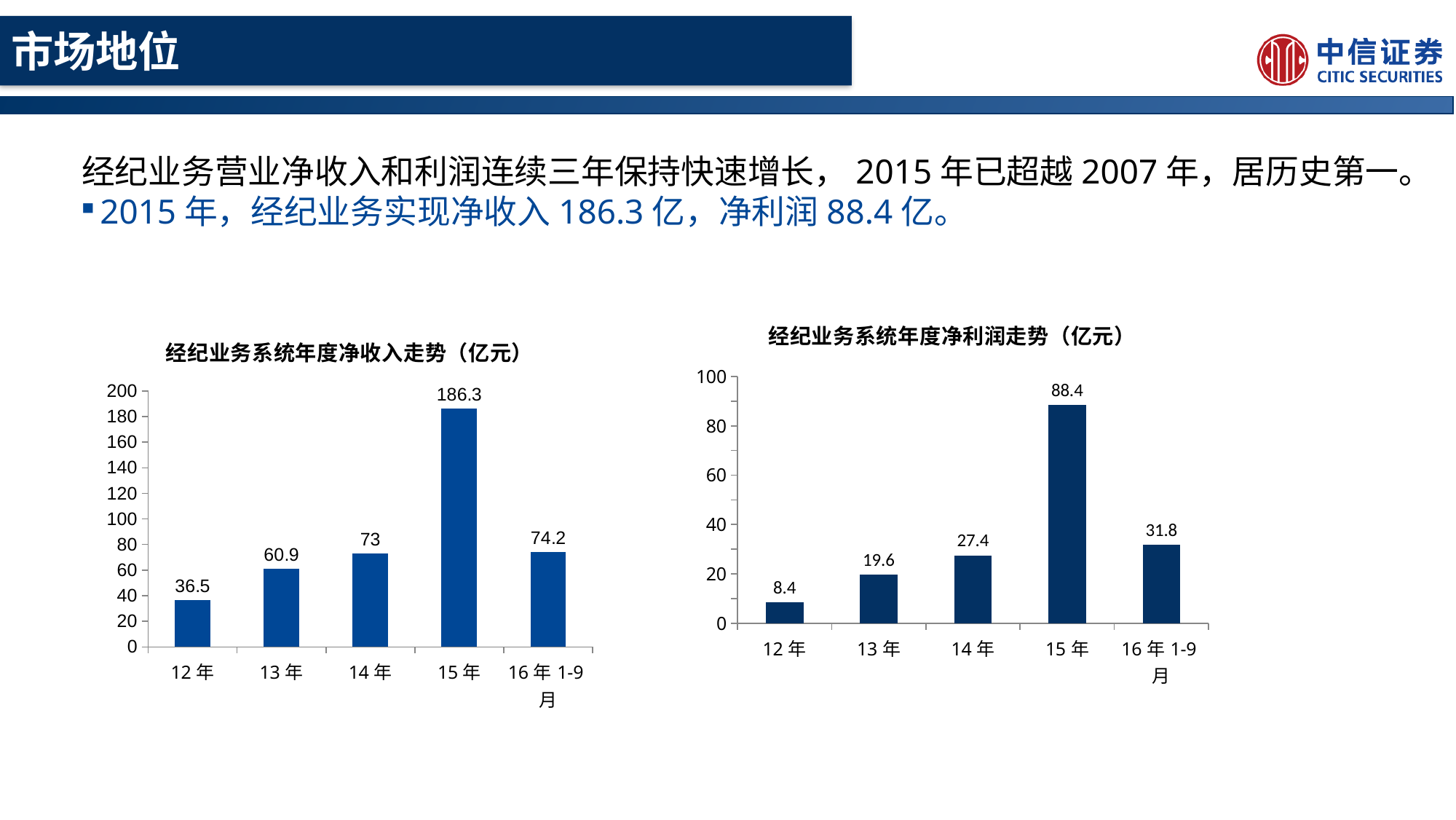
What kind of chart is the right chart (经纪业务系统年度净利润走势)? bar chart In the right chart (经纪业务系统年度净利润走势), do the values rise or fall from 12 年 to 15 年? rise What is the title of the left chart? 经纪业务系统年度净收入走势（亿元） In the left chart (经纪业务系统年度净收入走势), which category has the lowest value? 12 年 In the left chart (经纪业务系统年度净收入走势), what is the difference between the values for 15 年 and 14 年? 113.3 In the right chart (经纪业务系统年度净利润走势), what is the value for 14 年? 27.4 In the left chart (经纪业务系统年度净收入走势), what is the value for 15 年? 186.3 In the right chart (经纪业务系统年度净利润走势), what is the difference between the values for 13 年 and 12 年? 11.2 In the left chart (经纪业务系统年度净收入走势), which is larger: the value for 16 年 1-9 月 or the value for 14 年? 16 年 1-9 月 How many categories are shown on the x axis of the left chart (经纪业务系统年度净收入走势)? 5 In the right chart (经纪业务系统年度净利润走势), is the value for 16 年 1-9 月 greater or less than 40? less In the right chart (经纪业务系统年度净利润走势), which category has the highest value? 15 年